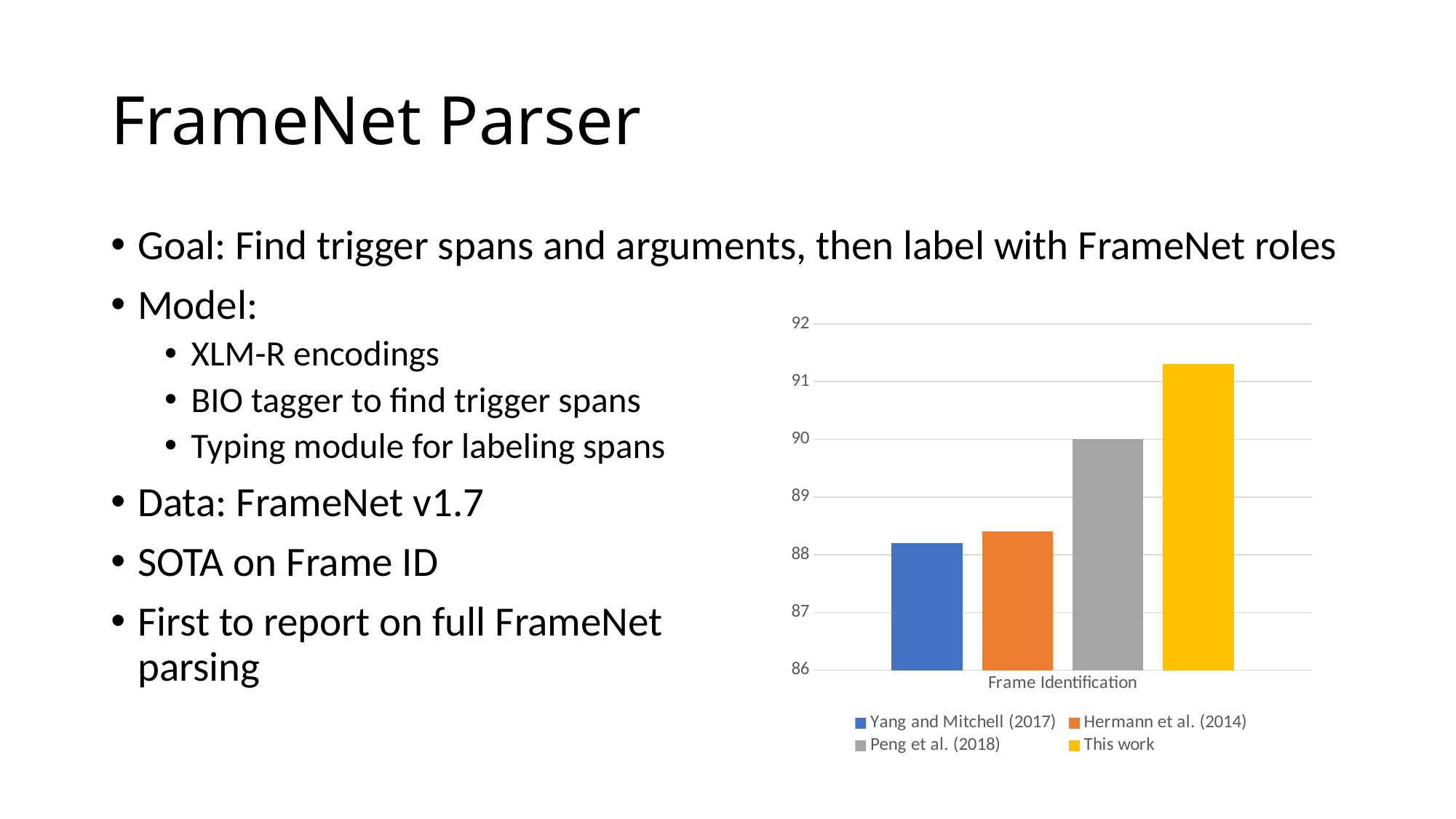
What is the category label shown on the x axis of the chart? Frame Identification Is the Frame Identification value for Yang and Mitchell (2017) greater or less than 89? less Is the Frame Identification value for This work greater or less than 91? greater Which series has the highest Frame Identification score? This work What is the lowest value shown on the chart's y axis? 86 Is the Frame Identification value for Hermann et al. (2014) greater or less than 89? less Which is larger, the Frame Identification value for This work or for Peng et al. (2018)? This work What kind of chart is shown on the slide? bar chart Which is larger, the Frame Identification value for Peng et al. (2018) or for Hermann et al. (2014)? Peng et al. (2018) What colour is the bar for This work? yellow How many series does the legend list? 4